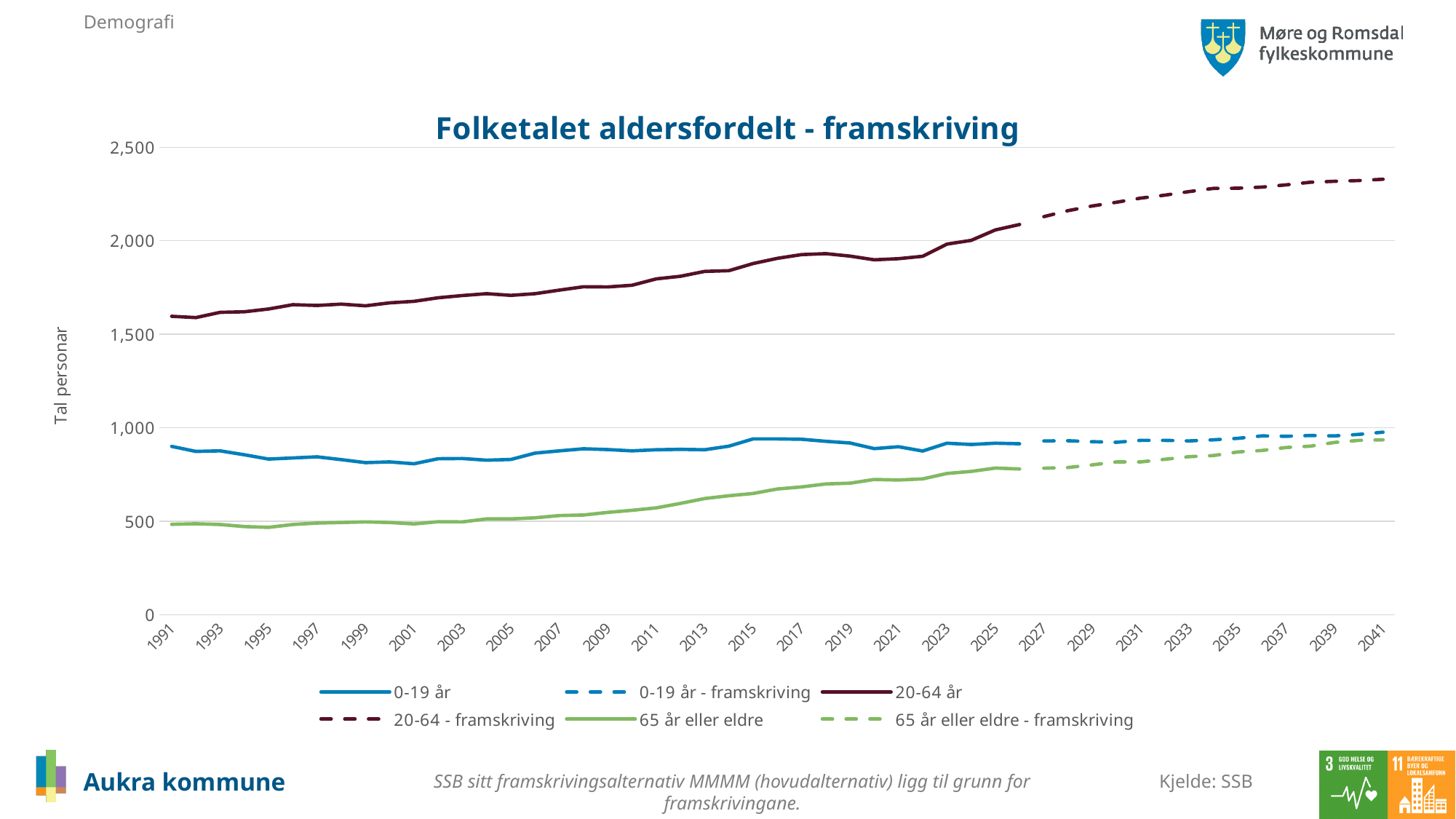
What is the label on the vertical axis? Tal personar Is the value for 20-64 - framskriving in 2041 greater or less than 2,000? greater Which series has the highest values throughout the chart? 20-64 år Is the value for 65 år eller eldre in 2025 greater or less than 500? greater What kind of chart is shown on the slide? line chart In 2001, which is larger: the value for 0-19 år or the value for 65 år eller eldre? 0-19 år Is the value for 20-64 år in 1991 greater or less than 1,500? greater What is the title of the chart? Folketalet aldersfordelt - framskriving Does the 65 år eller eldre series rise or fall from 2005 to 2025? rise Which series has the lowest value in 1991? 65 år eller eldre How many series does the legend list? 6